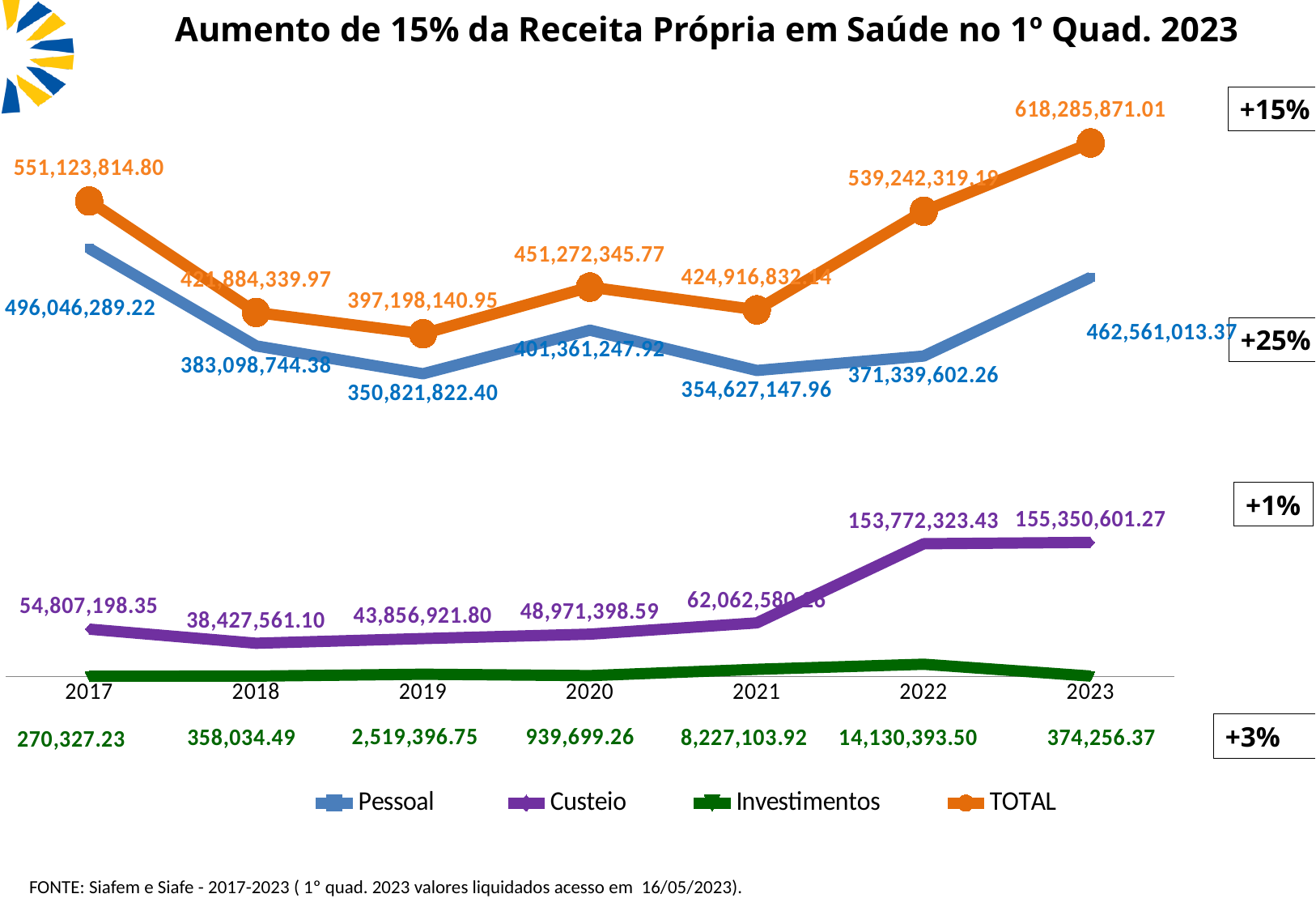
In which year is the Pessoal value lowest? 2019 What is the difference between the Custeio values for 2023 and 2022? 1,578,277.84 What is the Pessoal value for 2019? 350,821,822.40 Does the Custeio series rise or fall from 2018 to 2023? Rise In which year is the Investimentos value highest? 2022 What is the TOTAL value for 2023? 618,285,871.01 What is the Investimentos value for 2021? 8,227,103.92 What kind of chart is shown on the slide? Line chart Which is larger, the TOTAL value for 2017 or the TOTAL value for 2020? 2017 How many series does the legend list? 4 How many years are plotted along the x axis? 7 What is the Custeio value for 2018? 38,427,561.10